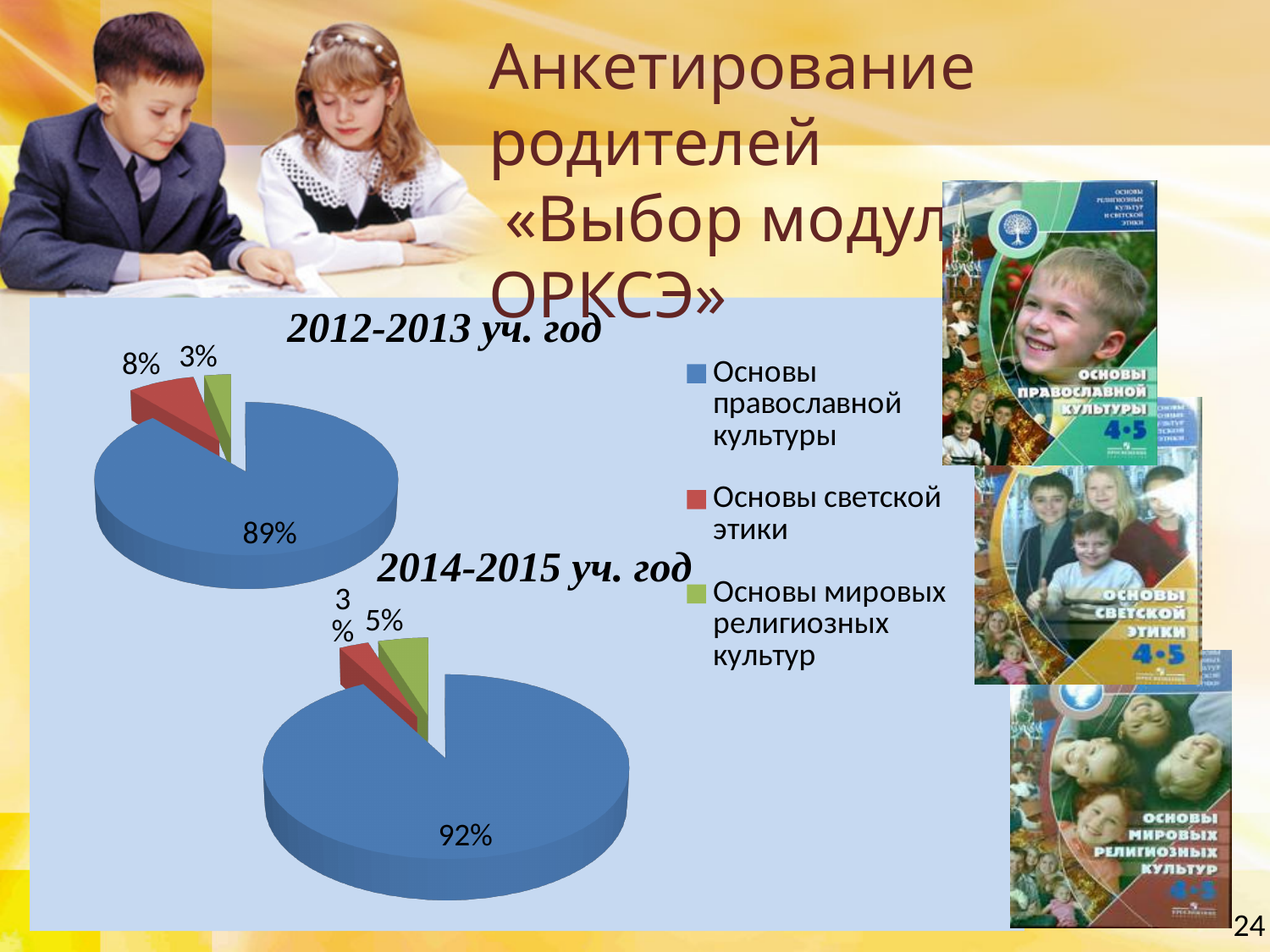
In the 2014-2015 уч. год pie chart, what share is shown for Основы православной культуры? 92% In the 2014-2015 уч. год pie chart, which module has the largest share? Основы православной культуры In the 2014-2015 уч. год pie chart, what share is shown for Основы светской этики? 3% How many entries does the legend list for the pie charts? 3 In the 2012-2013 уч. год pie chart, which module has the smallest share? Основы мировых религиозных культур In the 2014-2015 уч. год pie chart, what share is shown for Основы мировых религиозных культур? 5% What is the difference between the share for Основы православной культуры in the 2014-2015 уч. год chart and in the 2012-2013 уч. год chart? 3% In the 2014-2015 уч. год pie chart, which is larger: the share for Основы светской этики or for Основы мировых религиозных культур? Основы мировых религиозных культур In the 2012-2013 уч. год pie chart, what share is shown for Основы светской этики? 8% In the 2012-2013 уч. год pie chart, what share is shown for Основы мировых религиозных культур? 3% In the 2012-2013 уч. год pie chart, what share is shown for Основы православной культуры? 89% What type of chart is used for the 2012-2013 уч. год data? Pie chart